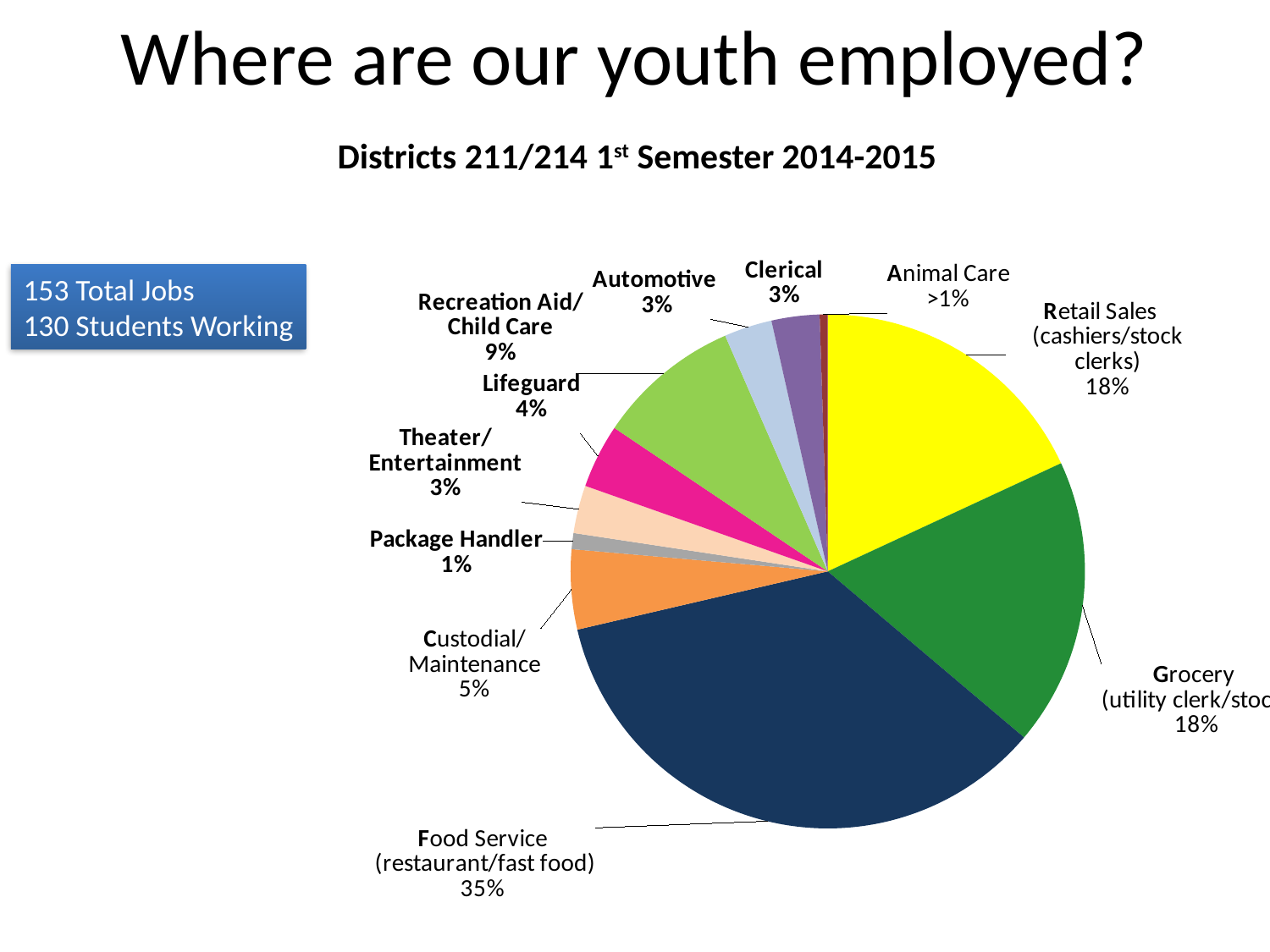
What percentage is shown for Custodial/Maintenance? 5% What percentage is shown for Recreation Aid/Child Care? 9% What is the subtitle above the chart? Districts 211/214 1st Semester 2014-2015 What kind of chart is shown on the slide? Pie chart What share of the pie does Food Service (restaurant/fast food) represent? 35% What is the difference in percentage points between Food Service and Retail Sales? 17 Which is larger, the Lifeguard slice or the Theater/Entertainment slice? Lifeguard What percentage is shown for Package Handler? 1% Which category has the largest slice of the pie? Food Service (restaurant/fast food) What is the combined percentage of Retail Sales and Grocery? 36% How many categories are shown in the pie chart? 11 Which category has the smallest slice of the pie? Animal Care